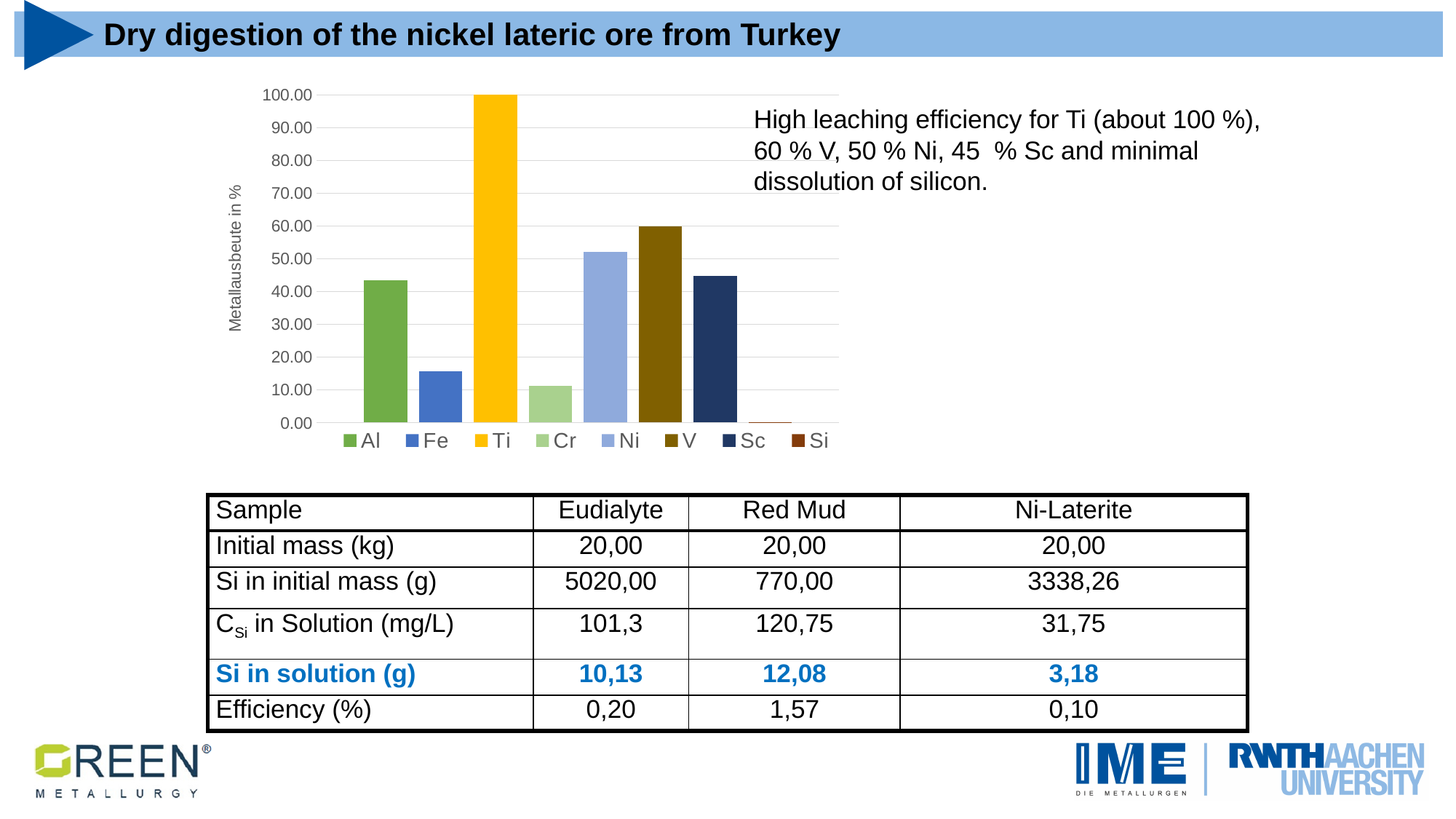
What kind of chart is shown on the slide? bar chart What colour is the bar for Ti in the chart? yellow Which has the larger Metallausbeute, Ni or Sc? Ni Which has the larger Metallausbeute, Al or Fe? Al Which element has the lowest Metallausbeute in the chart? Si What is the label of the vertical axis of the chart? Metallausbeute in % Is the value for Cr greater or less than 20.00? less Is the value for Al greater or less than 40.00? greater How many entries does the chart legend list? 8 Is the value for V greater or less than 50.00? greater Which element has the highest Metallausbeute in the chart? Ti